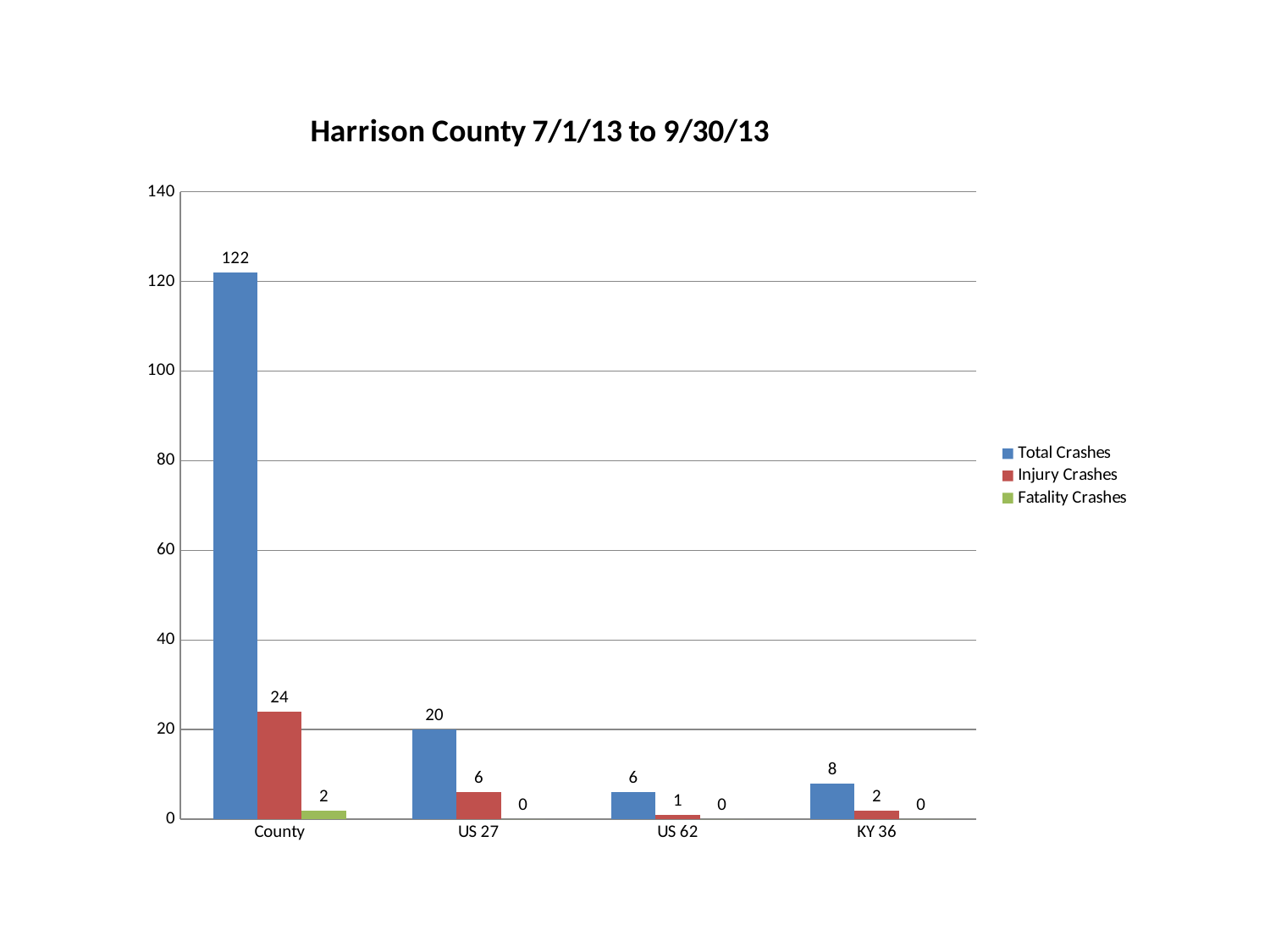
Which category has the lowest Total Crashes? US 62 Which category has the highest Total Crashes? County How many series does the legend list? 3 What is the value of Injury Crashes for US 27? 6 Which is larger, Injury Crashes for US 62 or Injury Crashes for KY 36? KY 36 Is the value of Total Crashes for County greater or less than 100? greater What is the difference between Total Crashes for US 27 and Total Crashes for KY 36? 12 What is the value of Fatality Crashes for KY 36? 0 What is the value of Total Crashes for County? 122 What kind of chart is shown on the slide? bar chart How many categories are shown on the x axis? 4 What is the title of the chart? Harrison County 7/1/13 to 9/30/13